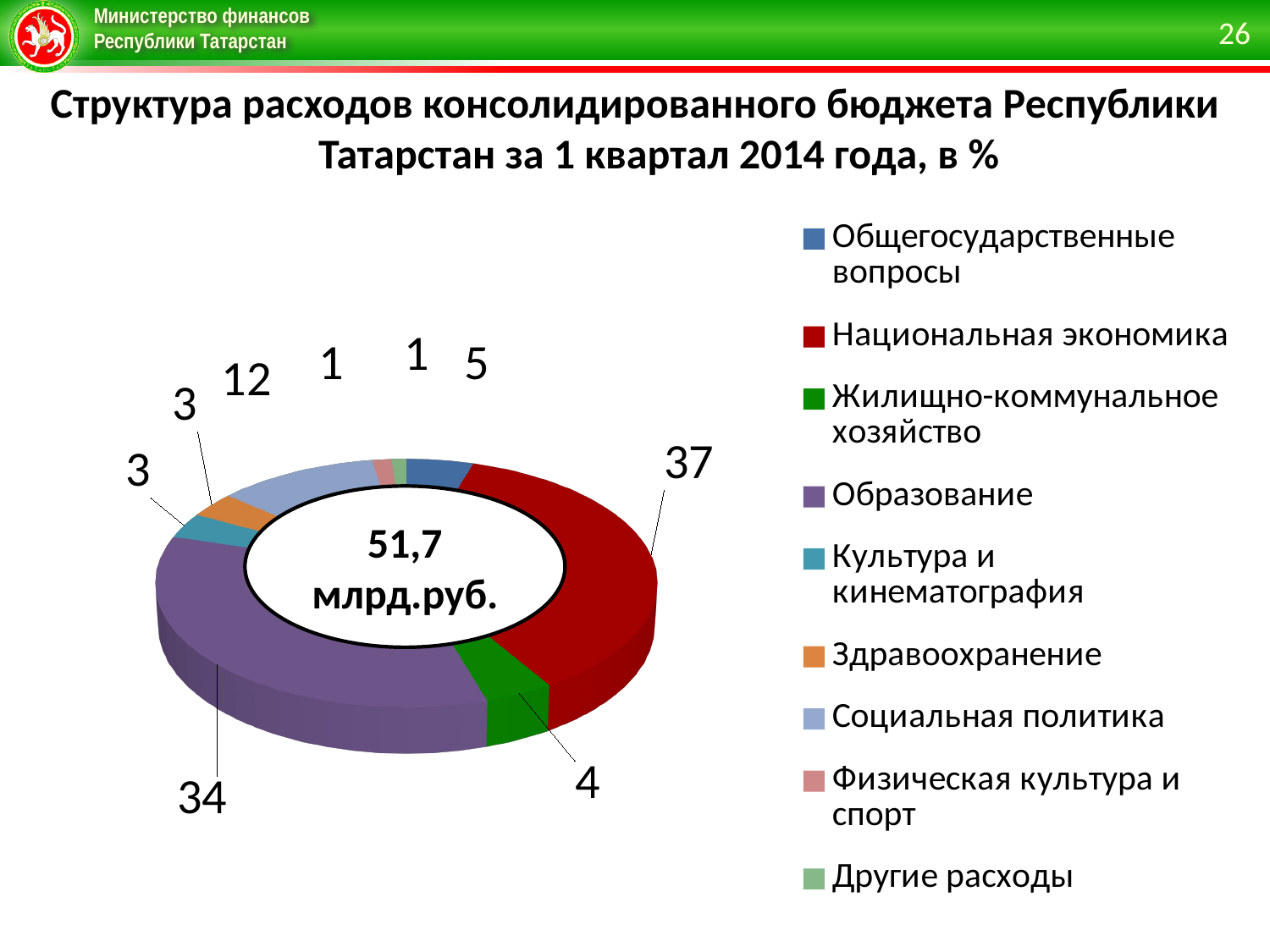
What share of expenditure is labelled for Национальная экономика? 37 How many categories does the legend list? 9 What share of expenditure is labelled for Образование? 34 What is the difference between the shares for Национальная экономика and Образование? 3 Which is larger, the share for Социальная политика or the share for Общегосударственные вопросы? Социальная политика What colour is the slice for Образование? Purple What kind of chart is shown on the slide? Pie chart Which category has the largest share of the pie? Национальная экономика What total amount is written in the centre of the chart? 51,7 млрд.руб. What share of expenditure is labelled for Жилищно-коммунальное хозяйство? 4 What share of expenditure is labelled for Общегосударственные вопросы? 5 What share of expenditure is labelled for Социальная политика? 12